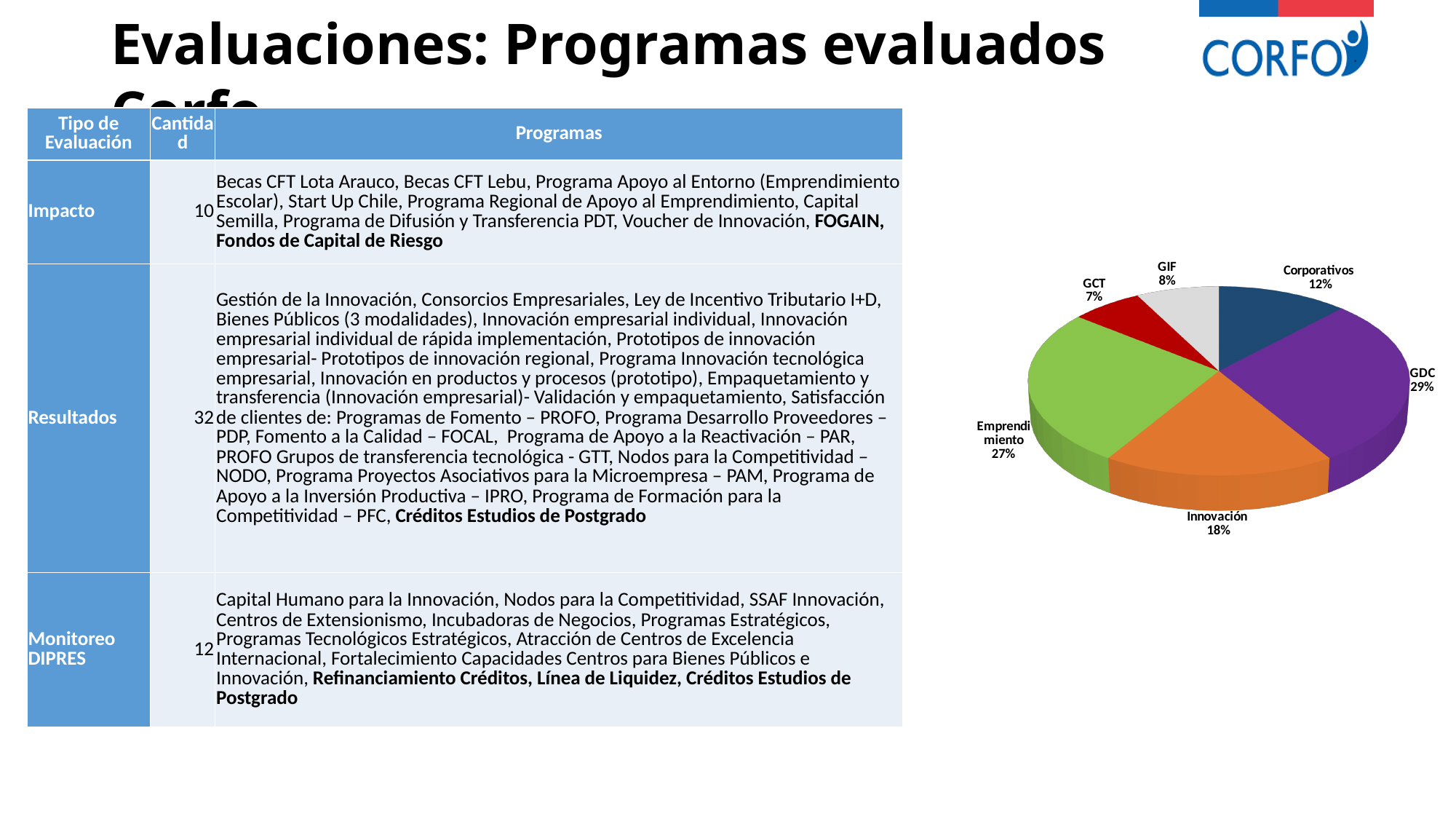
What share of the pie chart does GCT represent? 7% What share of the pie chart does GDC represent? 29% What is the difference in percentage points between the GDC and Innovación slices? 11 How many slices does the pie chart have? 6 What share of the pie chart does GIF represent? 8% Which slice is larger in the pie chart, Corporativos or Emprendimiento? Emprendimiento What kind of chart is shown on the right side of the slide? pie chart Which slice of the pie chart is the largest? GDC What share of the pie chart does Emprendimiento represent? 27% What share of the pie chart does Corporativos represent? 12% What share of the pie chart does Innovación represent? 18% Which slice of the pie chart is the smallest? GCT